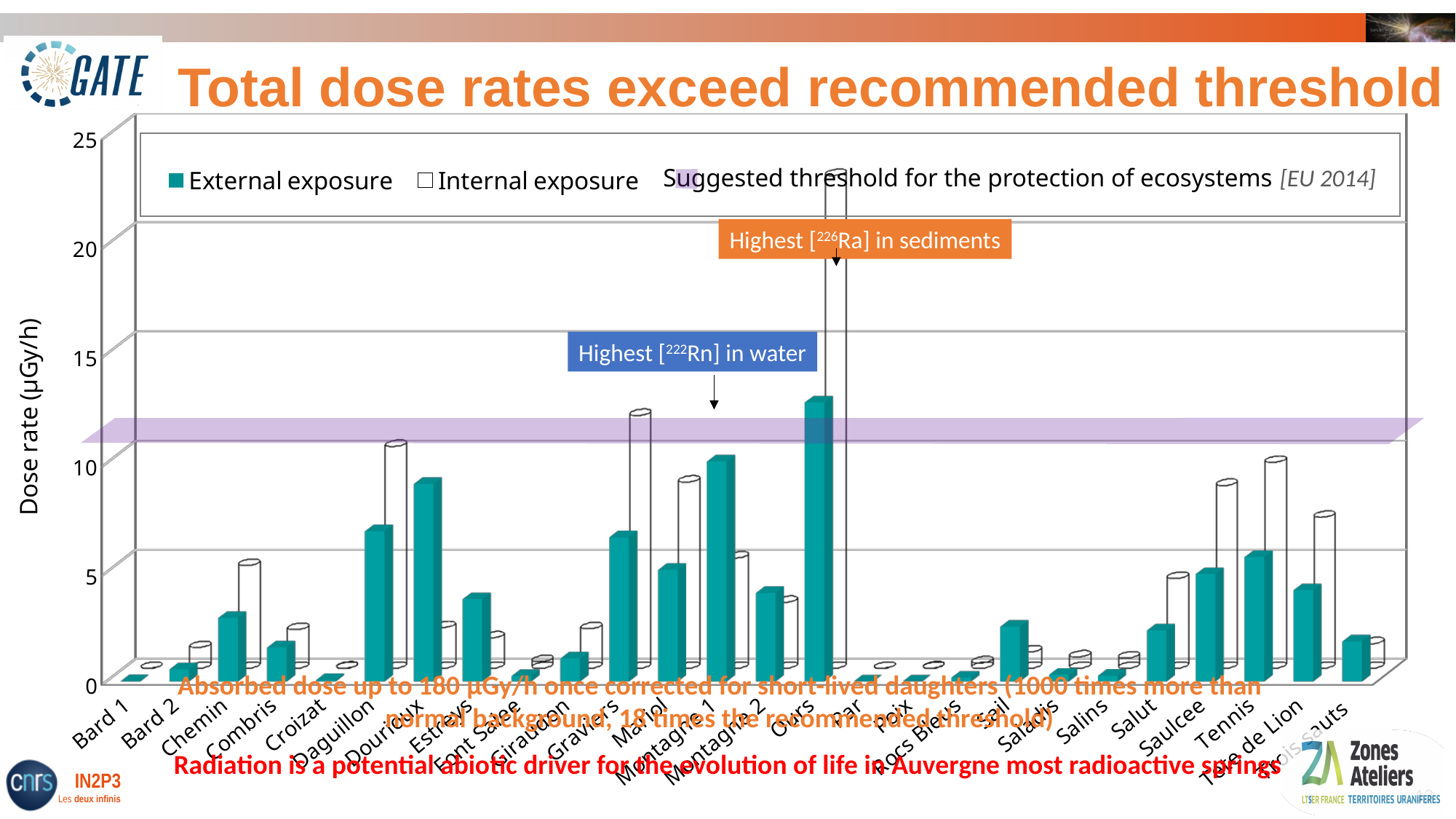
What does the purple horizontal band on the chart represent? Suggested threshold for the protection of ecosystems Which is larger, the External exposure for Dourioux or the External exposure for Daguillon? Dourioux What is the label of the vertical axis? Dose rate (µGy/h) Is the External exposure value for Chemin greater or less than 5? less For Chemin, which is larger, the External exposure or the Internal exposure? Internal exposure Is the External exposure value for Dourioux greater or less than 5? greater Which site has the highest External exposure value? Ours How many entries does the chart legend list? 3 What kind of chart is shown on the slide? bar chart Is the Internal exposure value for Ours greater or less than 20? greater Which site has the highest Internal exposure value? Ours